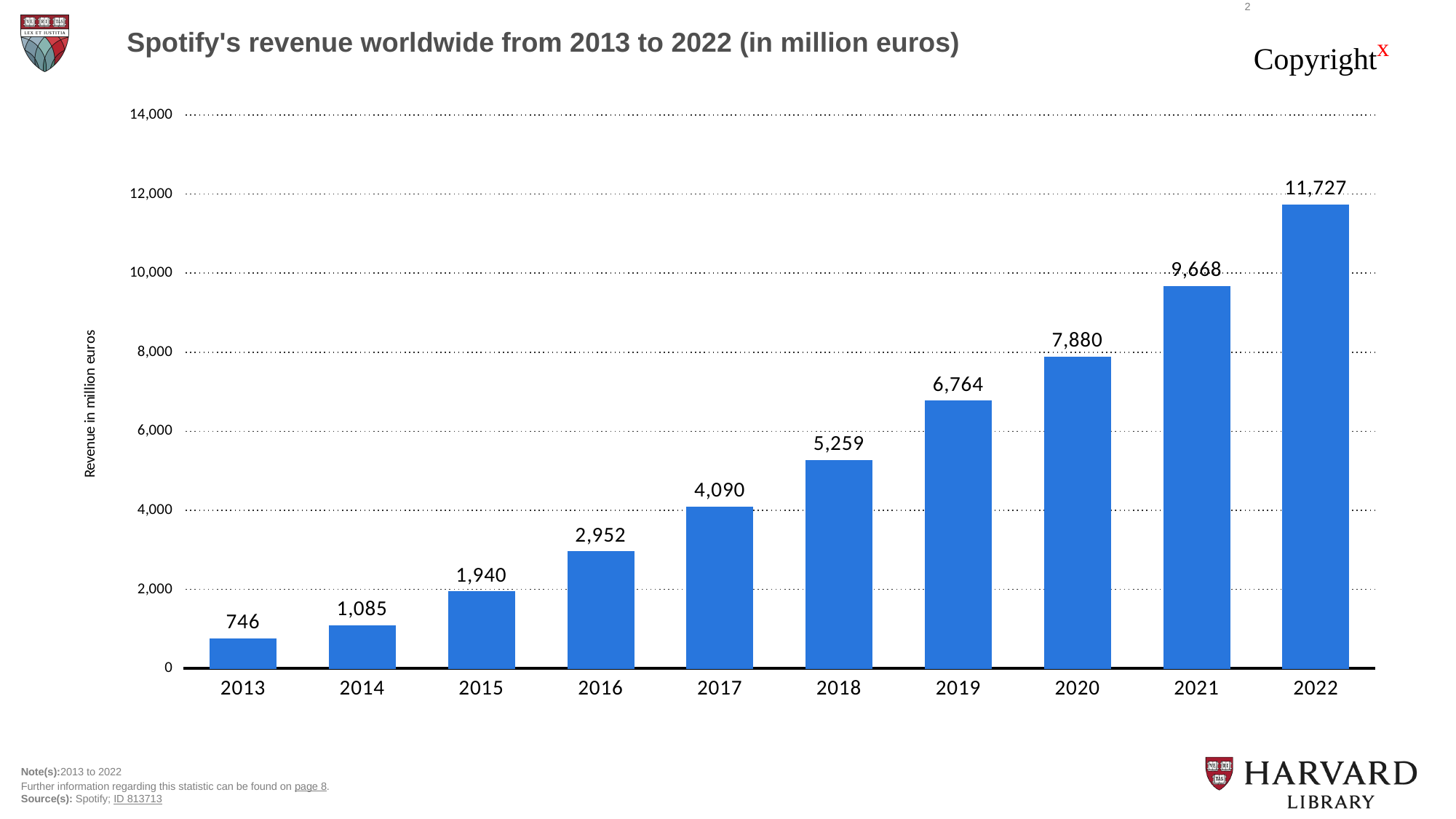
How many years are shown on the chart? 10 Which year has the lowest revenue? 2013 Which year had higher revenue, 2018 or 2019? 2019 What kind of chart is shown on the slide? bar chart Is the revenue for 2021 greater or less than 10,000? less What was Spotify's revenue worldwide in 2013? 746 What was Spotify's revenue worldwide in 2017? 4,090 Which year has the highest revenue? 2022 What was Spotify's revenue worldwide in 2020? 7,880 What is the difference in revenue between 2022 and 2021? 2,059 What is the difference in revenue between 2016 and 2015? 1,012 Does revenue rise or fall from 2013 to 2022? rise